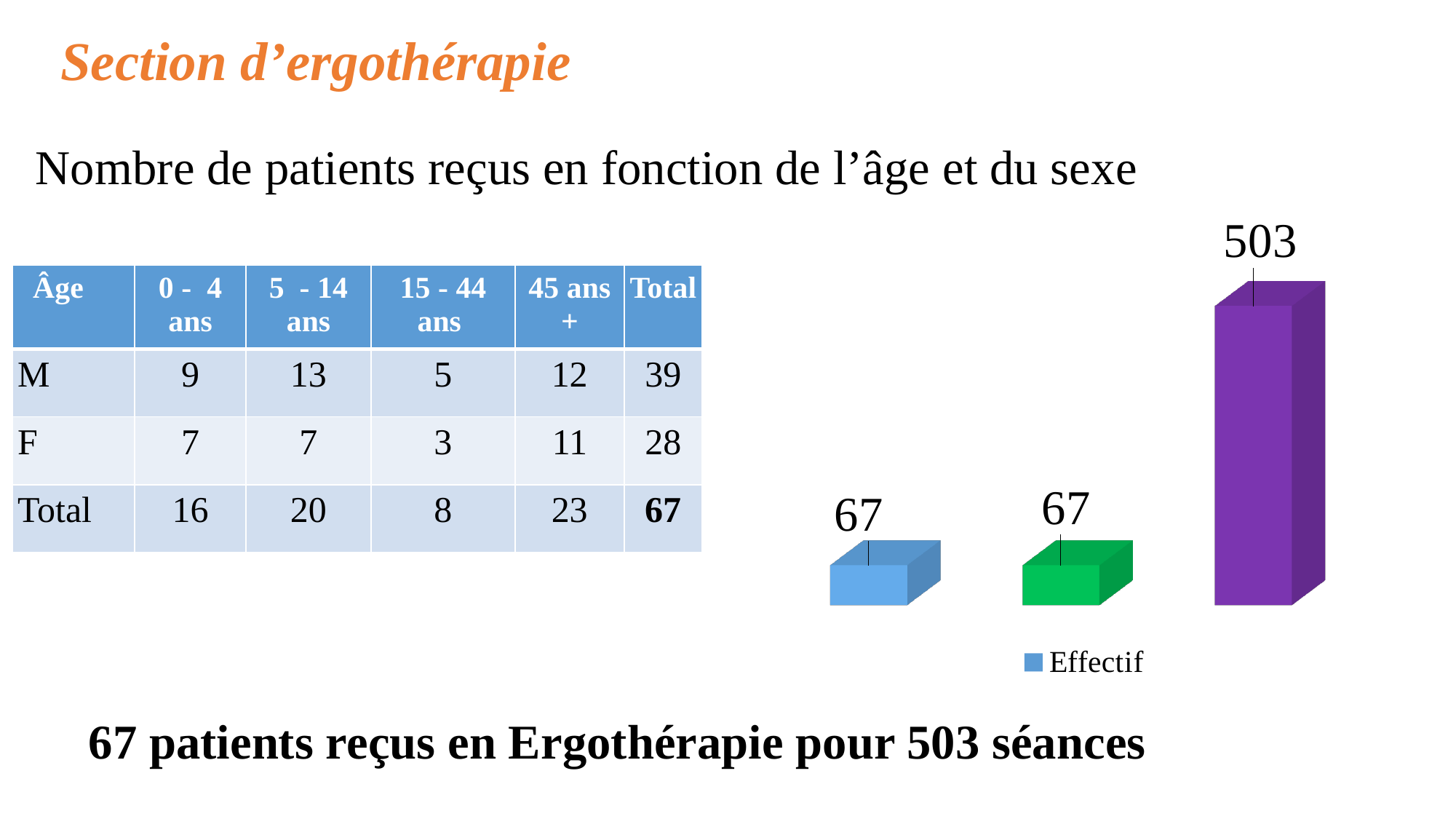
What colour is the tallest bar in the chart? purple What type of chart is shown on the right of the slide? bar chart How many bars does the chart on the right of the slide have? 3 Which bar in the chart has the highest value? the purple bar (503) What is the value shown on the middle (green) bar of the chart? 67 How many series does the chart legend list? 1 What is the value shown on the tallest (purple) bar of the chart? 503 Is the purple bar's value larger or smaller than the green bar's value? larger What is the value shown on the first (blue) bar of the chart? 67 Do the blue and green bars in the chart have the same value? yes What is the legend entry of the chart on the right of the slide? Effectif What is the difference between the purple bar's value and the blue bar's value? 436